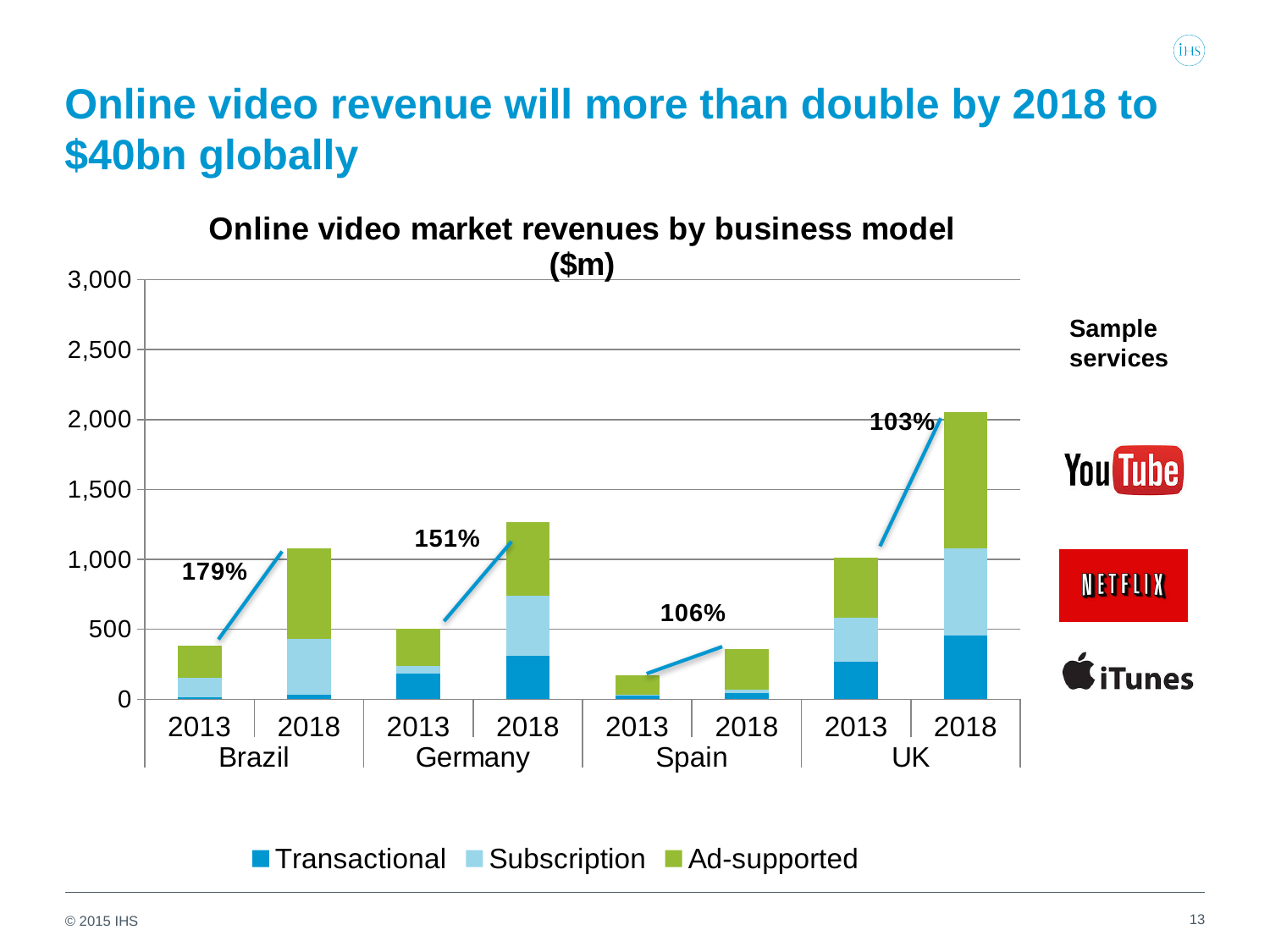
Which country and year has the tallest stacked bar? UK 2018 What growth percentage is printed above the Brazil bars? 179% Is the total for UK 2018 greater or less than 1,500? greater How many series does the legend list? 3 Which is larger, the 2018 total for Brazil or the 2018 total for UK? UK Which country and year has the shortest stacked bar? Spain 2013 How many countries are shown on the x axis? 4 Is the total for Spain 2018 greater or less than 500? less What growth percentage is printed above the UK bars? 103% What growth percentage is printed above the Germany bars? 151% What growth percentage is printed above the Spain bars? 106% What kind of chart is shown on the slide? Stacked bar chart